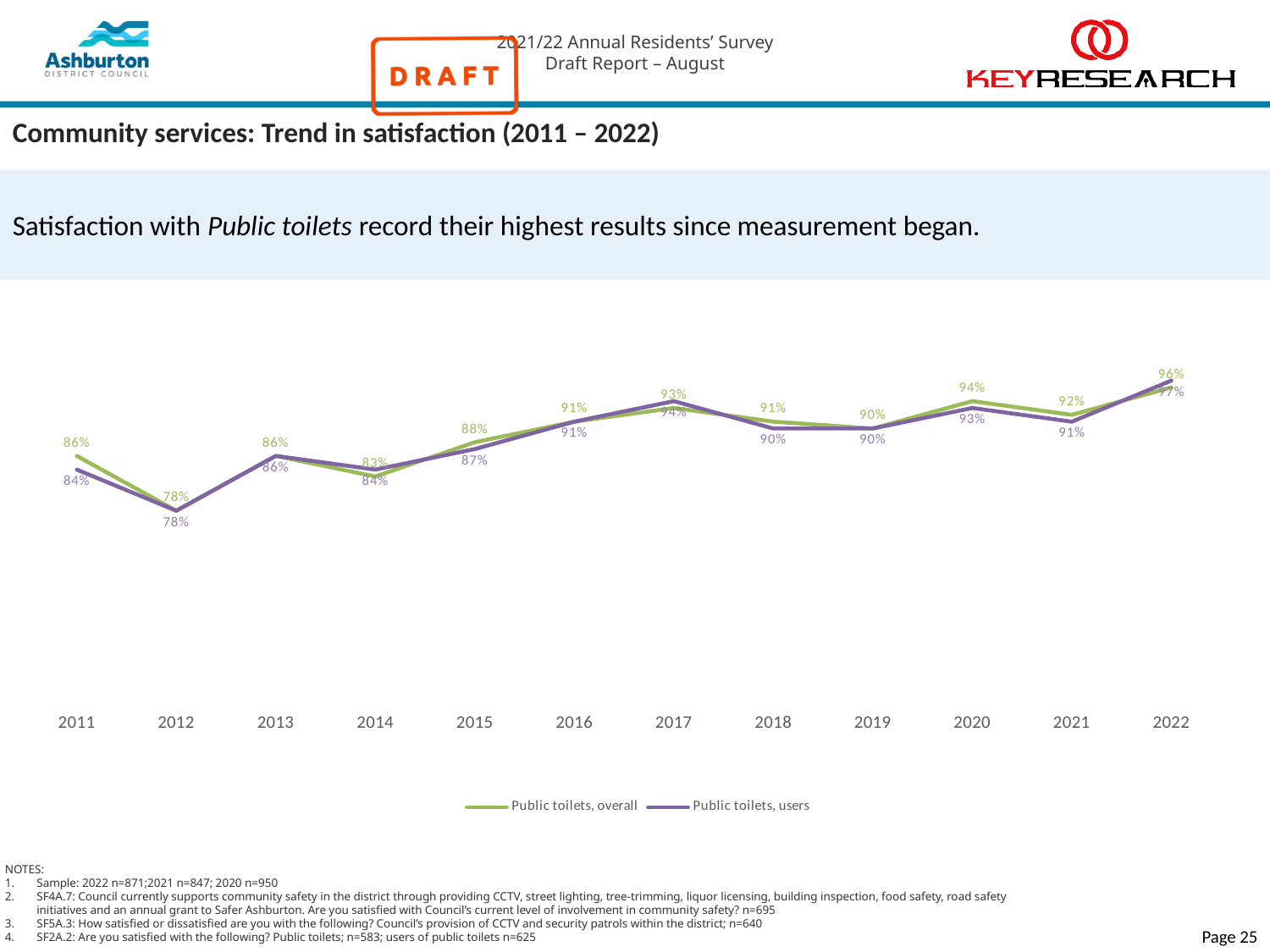
What is the value for Public toilets, users in 2017? 94% What is the value for Public toilets, users in 2020? 93% How many series does the legend list? 2 What kind of chart is shown on the slide? Line chart What is the difference between the Public toilets, overall values for 2011 and 2012? 8 percentage points How many years are plotted along the x axis? 12 In which year is Public toilets, overall at its highest? 2022 What is the value for Public toilets, overall in 2012? 78% In which year is Public toilets, overall at its lowest? 2012 What is the value for Public toilets, overall in 2022? 96% Does the Public toilets, overall series rise or fall from 2019 to 2020? Rise In 2015, which series has the higher value: Public toilets, overall or Public toilets, users? Public toilets, overall